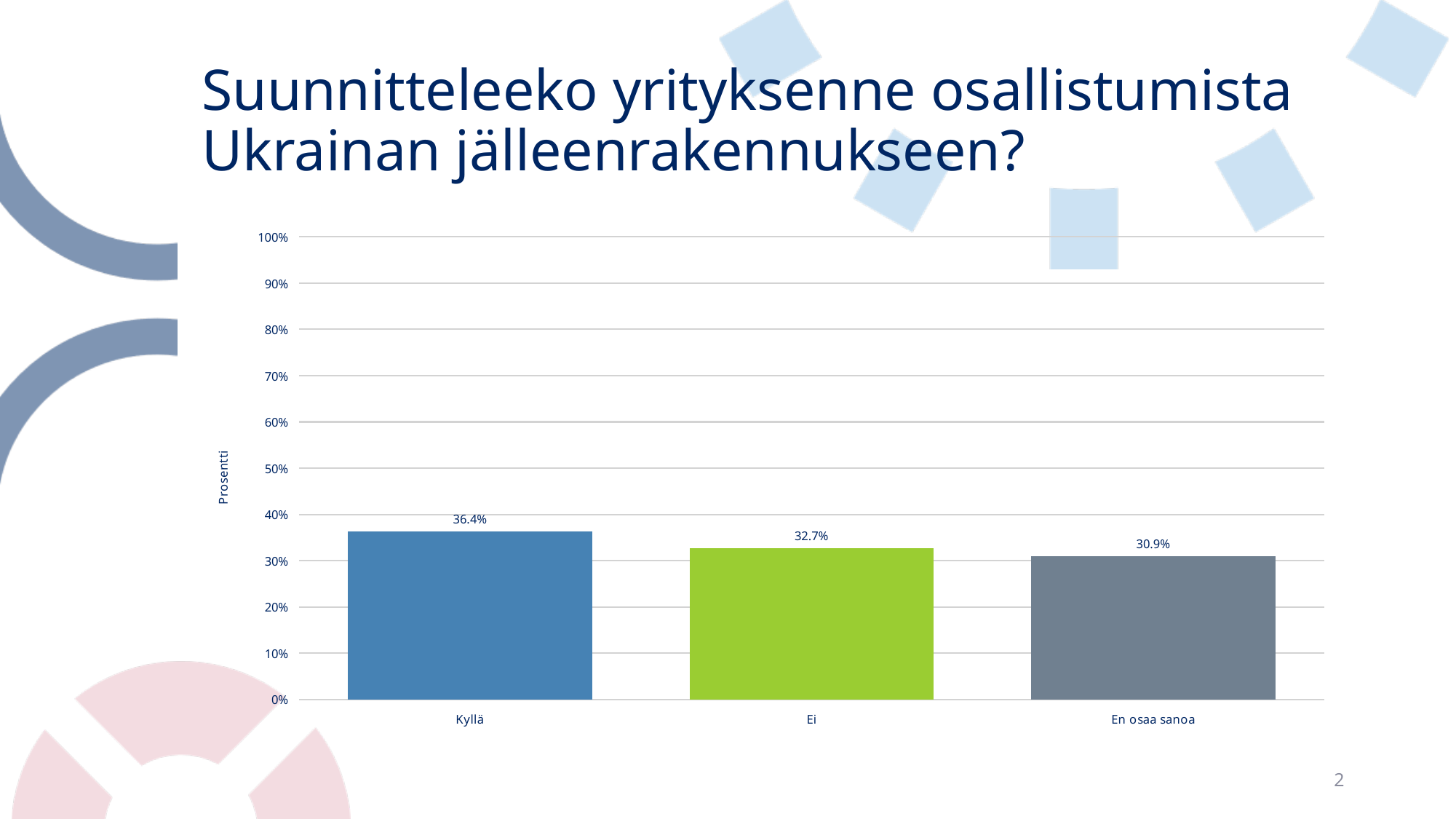
What kind of chart is shown on the slide? bar chart What is the difference between the values for Kyllä and Ei? 3.7% Is the value for Ei greater or less than 40%? less What is the difference between the values for Ei and En osaa sanoa? 1.8% Which category has the lowest value? En osaa sanoa How many categories are shown on the x axis? 3 What is the value for Ei? 32.7% What is the value for Kyllä? 36.4% Which is larger, the value for Kyllä or the value for En osaa sanoa? Kyllä What is the value for En osaa sanoa? 30.9% Which category has the highest value? Kyllä What is the label of the vertical axis? Prosentti